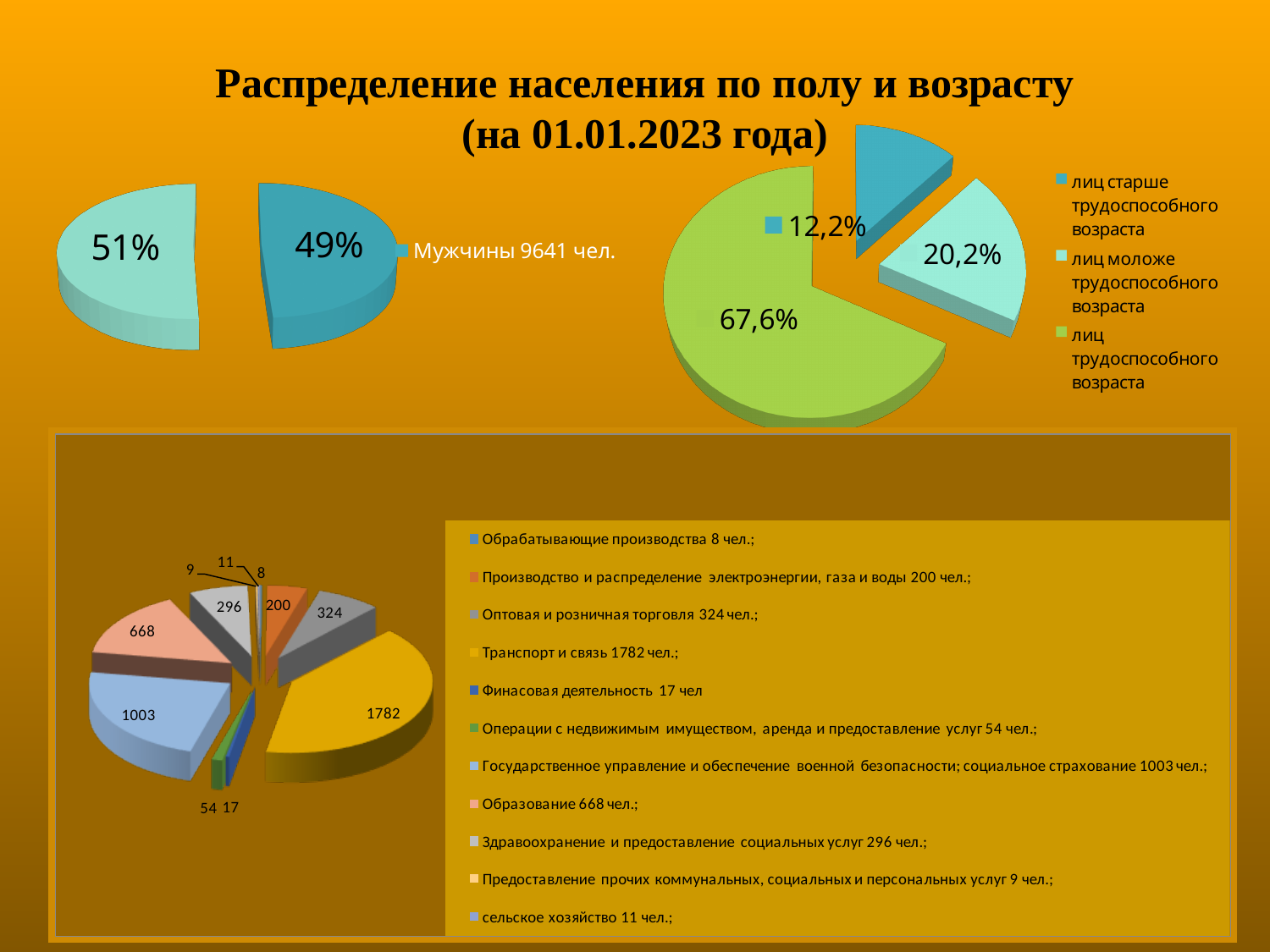
On the top-left pie chart, how many slices does the pie have? 2 On the bottom pie chart, which category has the largest value? Транспорт и связь What kind of chart is the bottom chart on the slide? pie chart On the bottom pie chart, what is the difference between the values for Транспорт и связь and Государственное управление и обеспечение военной безопасности; социальное страхование? 779 On the top-right pie chart, what share is shown for лиц трудоспособного возраста? 67,6% On the bottom pie chart, what is the value for Образование? 668 On the top-left pie chart, what share is shown for Мужчины? 49% On the top-right pie chart, which category has the smallest share? лиц старше трудоспособного возраста On the top-right pie chart, what is the difference between the shares for лиц трудоспособного возраста and лиц моложе трудоспособного возраста? 47,4% On the top-left pie chart, what is the larger of the two percentages shown? 51% On the bottom pie chart, how many categories are shown? 11 On the top-right pie chart, how many entries does the legend list? 3